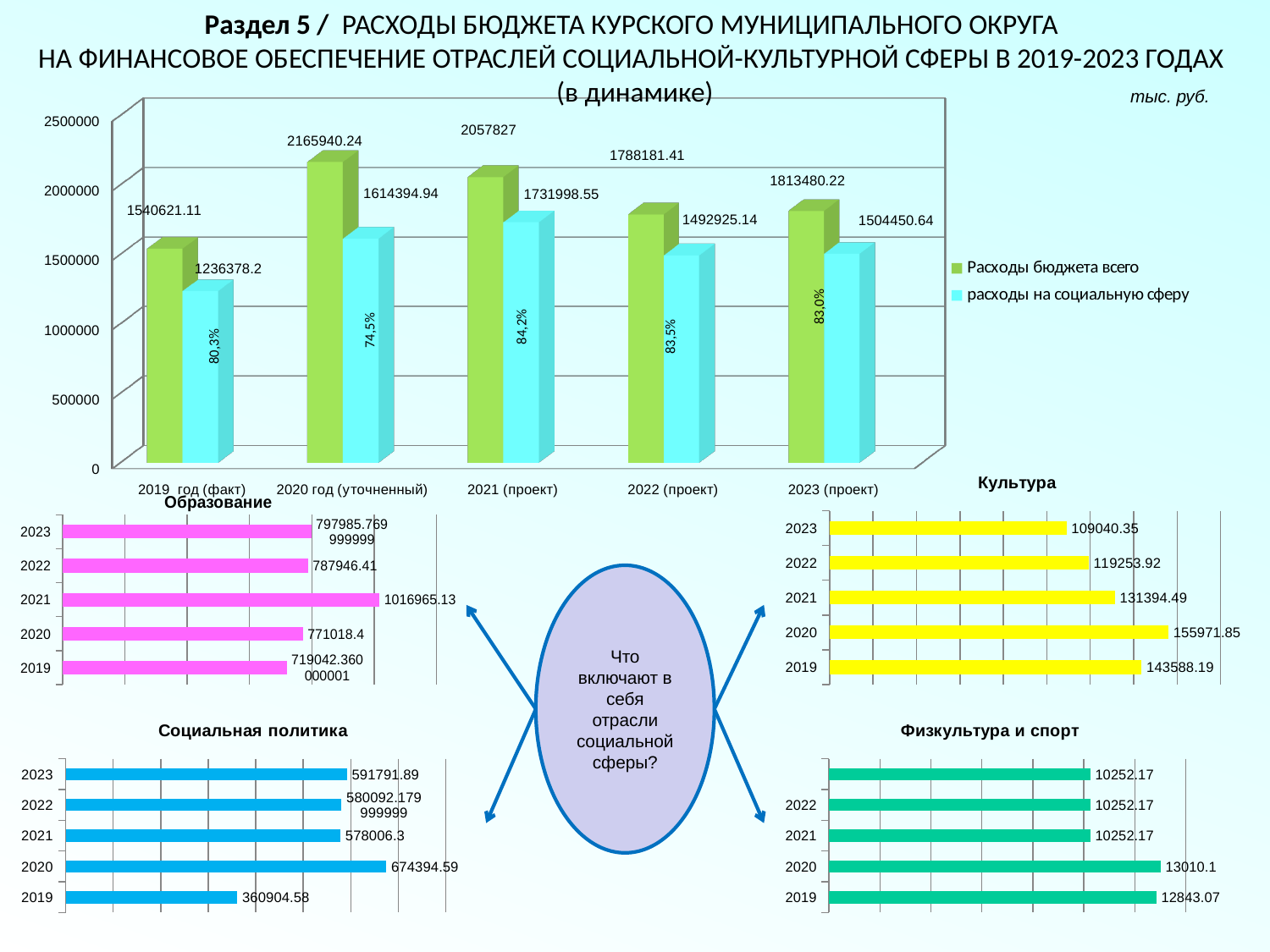
In the top chart, which year has the highest value of 'Расходы бюджета всего'? 2020 год (уточненный) How many series does the legend of the top chart list? 2 In the top chart, what is the value of 'Расходы бюджета всего' for 2020 год (уточненный)? 2165940.24 In the 'Социальная политика' chart, what is the value for 2020? 674394.59 How many year categories are shown on the x axis of the top chart? 5 In the 'Культура' chart, which year has the highest value? 2020 In the 'Образование' chart, which year has the highest value? 2021 In the 'Культура' chart, what is the value for 2023? 109040.35 In the 'Социальная политика' chart, which year has the lowest value? 2019 In the top chart, what is the value of 'расходы на социальную сферу' for 2021 (проект)? 1731998.55 In the 'Физкультура и спорт' chart, what is the value for 2020? 13010.1 In the top chart, what is the difference between 'Расходы бюджета всего' and 'расходы на социальную сферу' for 2020 год (уточненный)? 551545.3